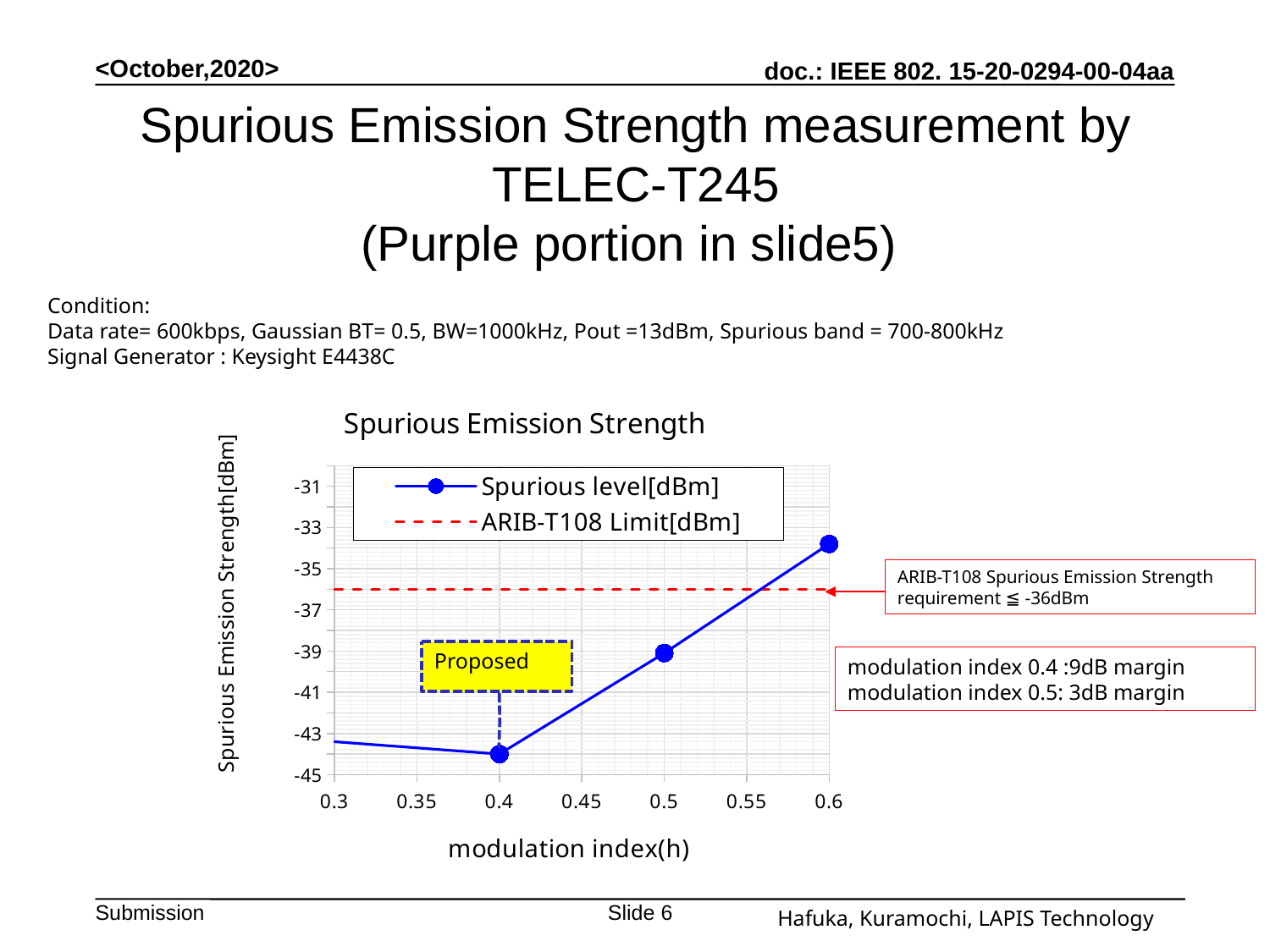
Which has the larger Spurious level[dBm], modulation index 0.5 or 0.6? 0.6 Is the Spurious level[dBm] at modulation index 0.4 greater or less than -43? less What kind of chart is shown on the slide? line chart What is the label of the x axis of the chart? modulation index(h) At which modulation index is the Spurious level[dBm] highest? 0.6 What is the ARIB-T108 Spurious Emission Strength requirement shown by the dashed limit line? ≦ -36dBm At which modulation index with a plotted marker is the Spurious level[dBm] lowest? 0.4 Is the Spurious level[dBm] at modulation index 0.6 greater or less than -35? greater How many series does the chart legend list? 2 Is the Spurious level[dBm] at modulation index 0.5 greater or less than -37? less Does the Spurious level[dBm] rise or fall as the modulation index increases from 0.4 to 0.6? rise What is the title of the chart? Spurious Emission Strength